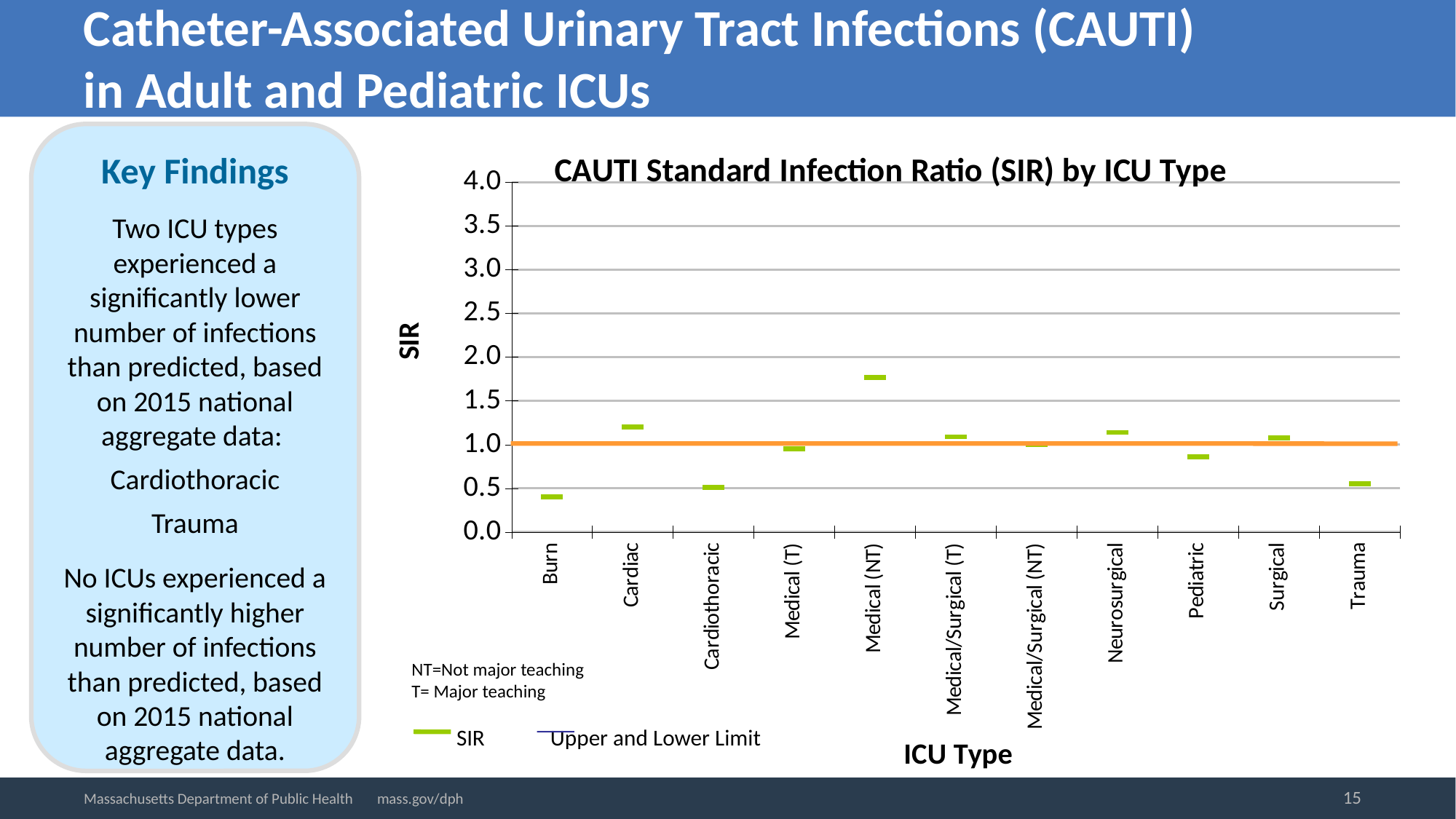
Is the SIR for Cardiac greater or less than 1.0? greater Which has a higher SIR, Medical (NT) or Pediatric? Medical (NT) Which has a higher SIR, Cardiac or Cardiothoracic? Cardiac How many series does the chart legend list? 2 Is the SIR for Trauma greater or less than 1.0? less Is the SIR for Burn greater or less than 0.5? less What is the title of the chart? CAUTI Standard Infection Ratio (SIR) by ICU Type What is the label on the y axis of the chart? SIR Which ICU type has the highest SIR in the chart? Medical (NT) How many ICU types are plotted on the x axis of the chart? 11 Which ICU type has the lowest SIR in the chart? Burn